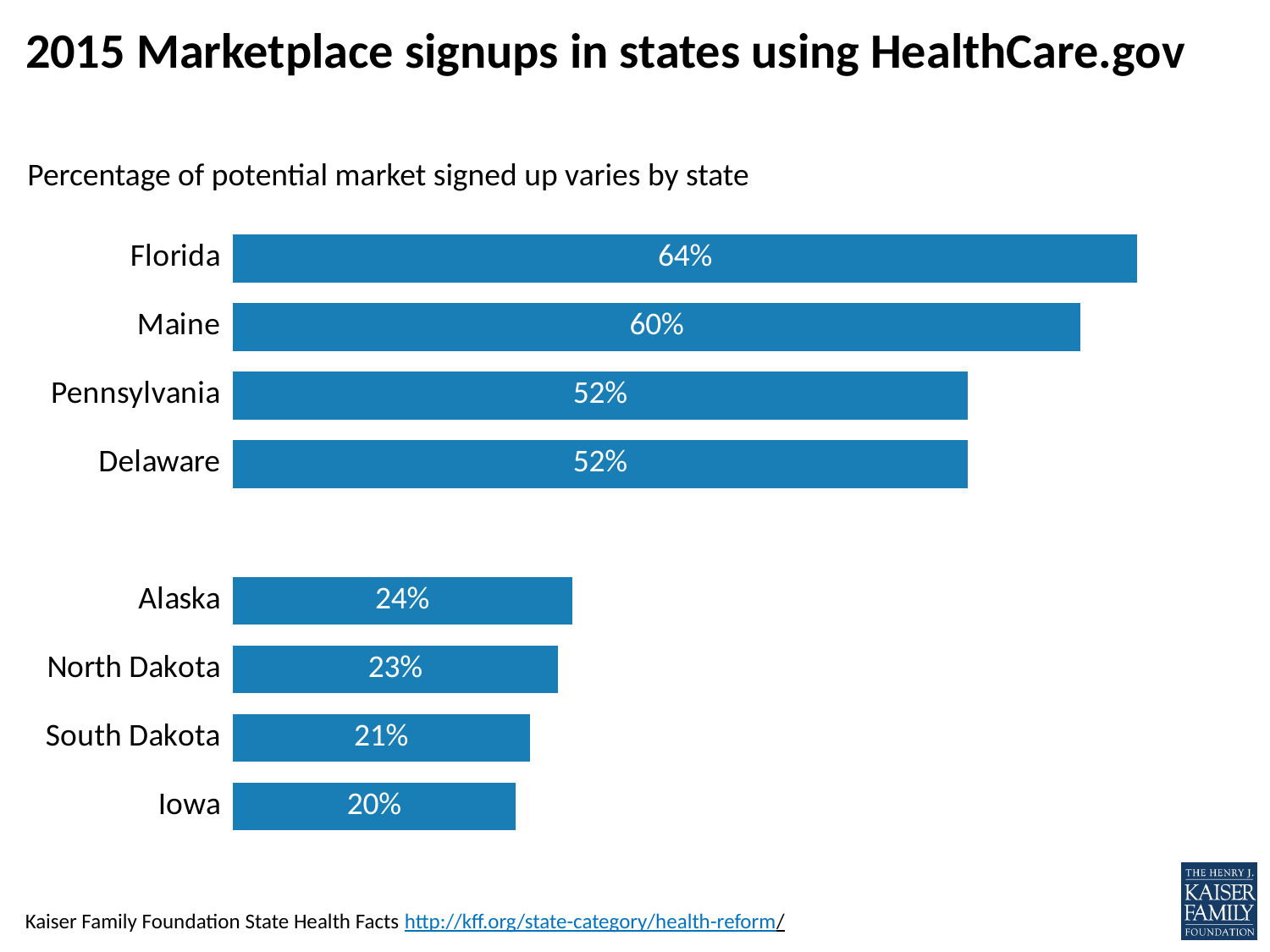
Which state has the lowest percentage shown on the chart? Iowa Which two states share the same value of 52%? Pennsylvania and Delaware What is the value for Iowa? 20% What is the difference in percentage points between Maine and Pennsylvania? 8 What percentage of the potential market signed up in Florida? 64% How many states are shown on the chart? 8 What percentage is shown for North Dakota? 23% What is the value shown for Maine? 60% Which state has the highest percentage of its potential market signed up? Florida What is the difference in percentage points between Florida and Iowa? 44 What kind of chart is shown on the slide? Bar chart Which has a higher value, Alaska or South Dakota? Alaska